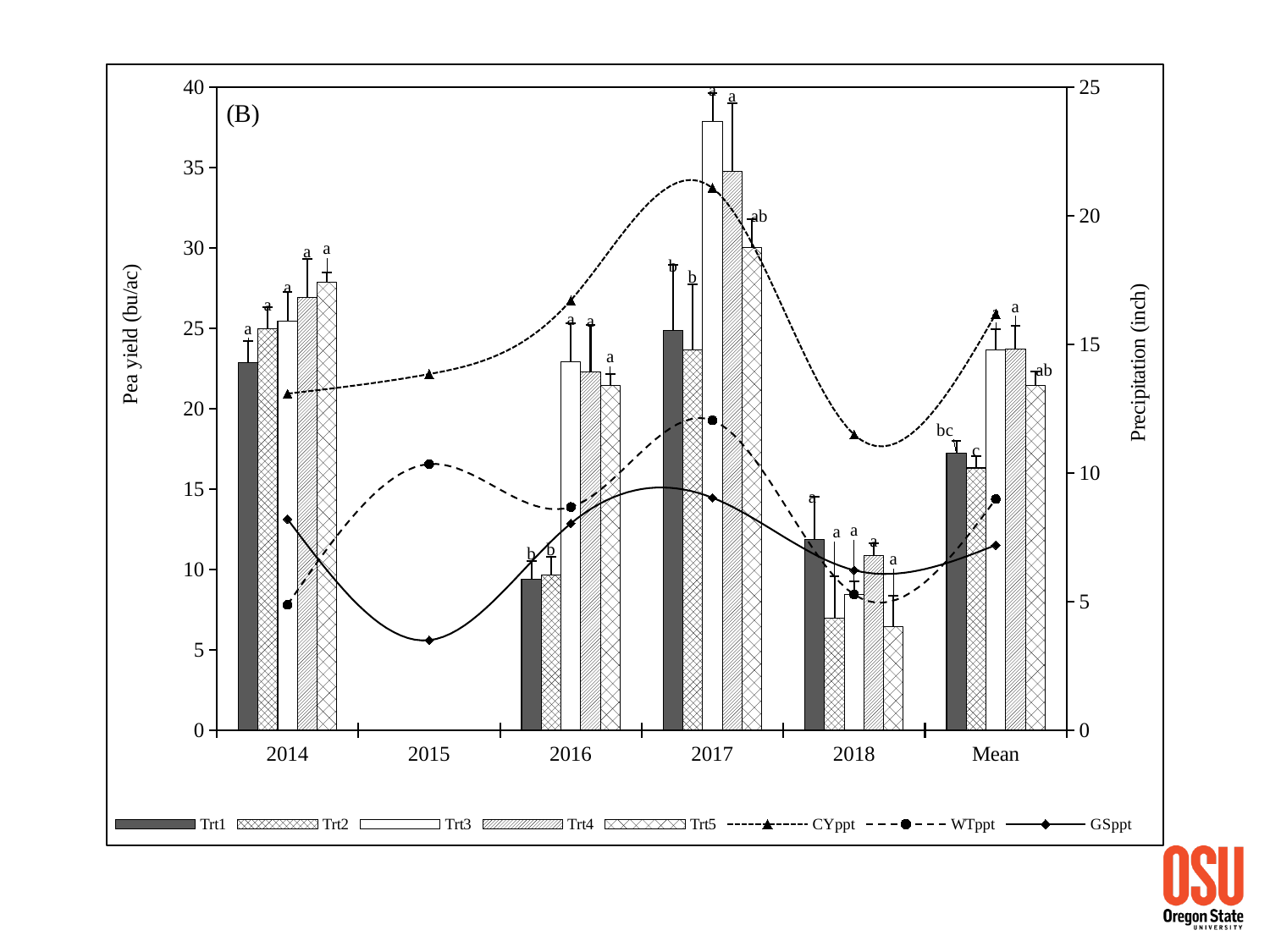
In which year is the Trt1 bar lowest? 2016 What kind of chart is shown on the slide? A combined bar and line chart What is the title of the left vertical axis? Pea yield (bu/ac) Is the Trt5 value for 2018 greater or less than 10? less Does the CYppt line rise or fall from 2015 to 2017? Rises Is the Trt1 value for 2016 greater or less than 10? less Is the Trt3 value for 2017 greater or less than 35? greater How many series does the legend list? 8 In 2017, which is larger, the Trt1 bar or the Trt3 bar? Trt3 How many categories are shown along the x axis? 6 In which year is the Trt3 bar highest? 2017